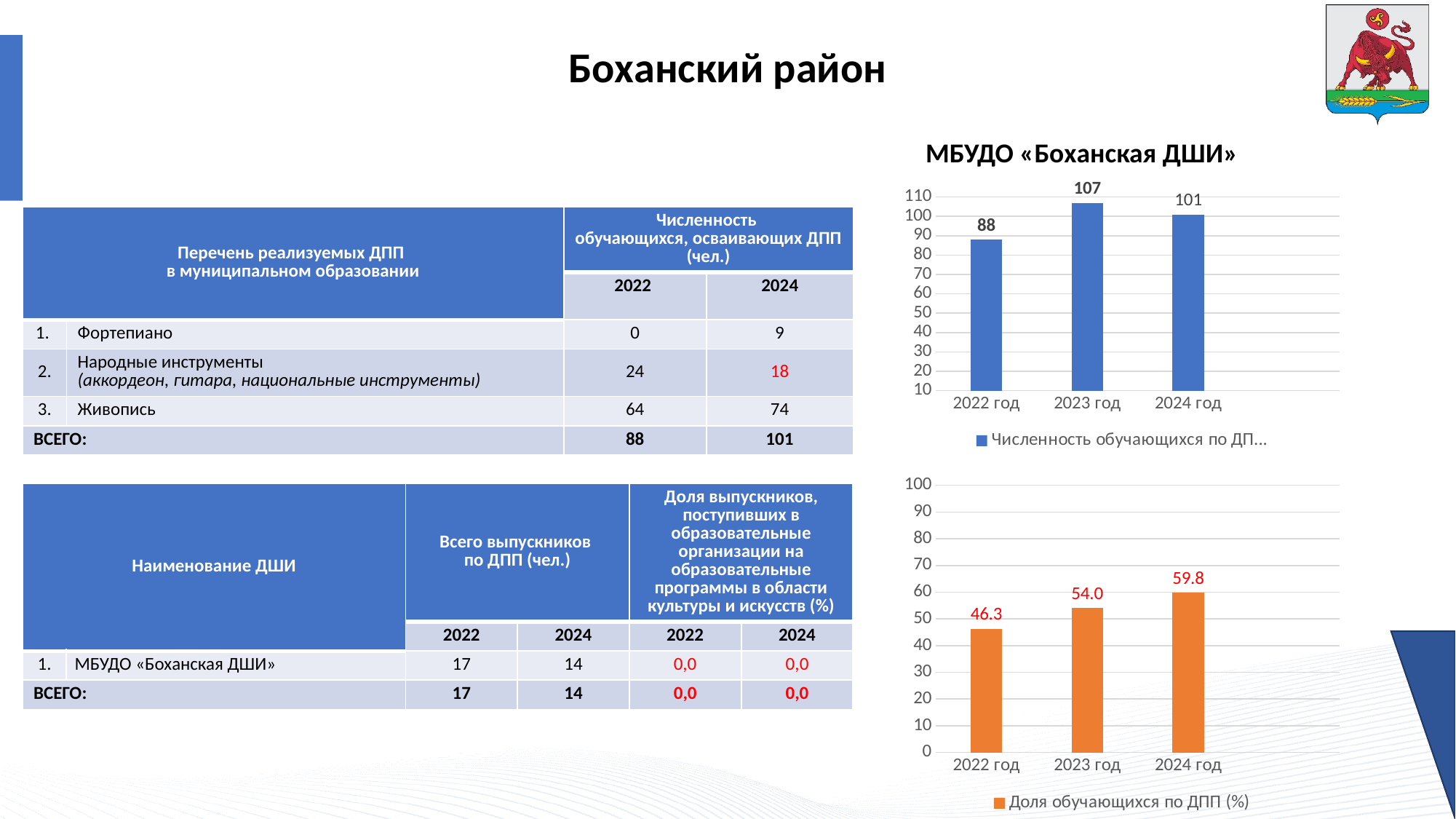
In the top chart, which year has the lowest value? 2022 год In the bottom chart, which year has the highest value? 2024 год In the bottom chart, what is the difference between the values for 2024 год and 2022 год? 13.5 In the top chart, which year has the highest value? 2023 год In the bottom chart, do the values rise or fall from 2022 год to 2024 год? rise In the top chart, what is the difference between the values for 2023 год and 2024 год? 6 What type of chart is the bottom chart? bar chart In the bottom chart, what is the value for 2022 год? 46.3 In the bottom chart, what is the value for 2024 год? 59.8 In the top chart, how many bars are plotted? 3 In the top chart, what is the value for 2022 год? 88 In the top chart, what is the value for 2023 год? 107